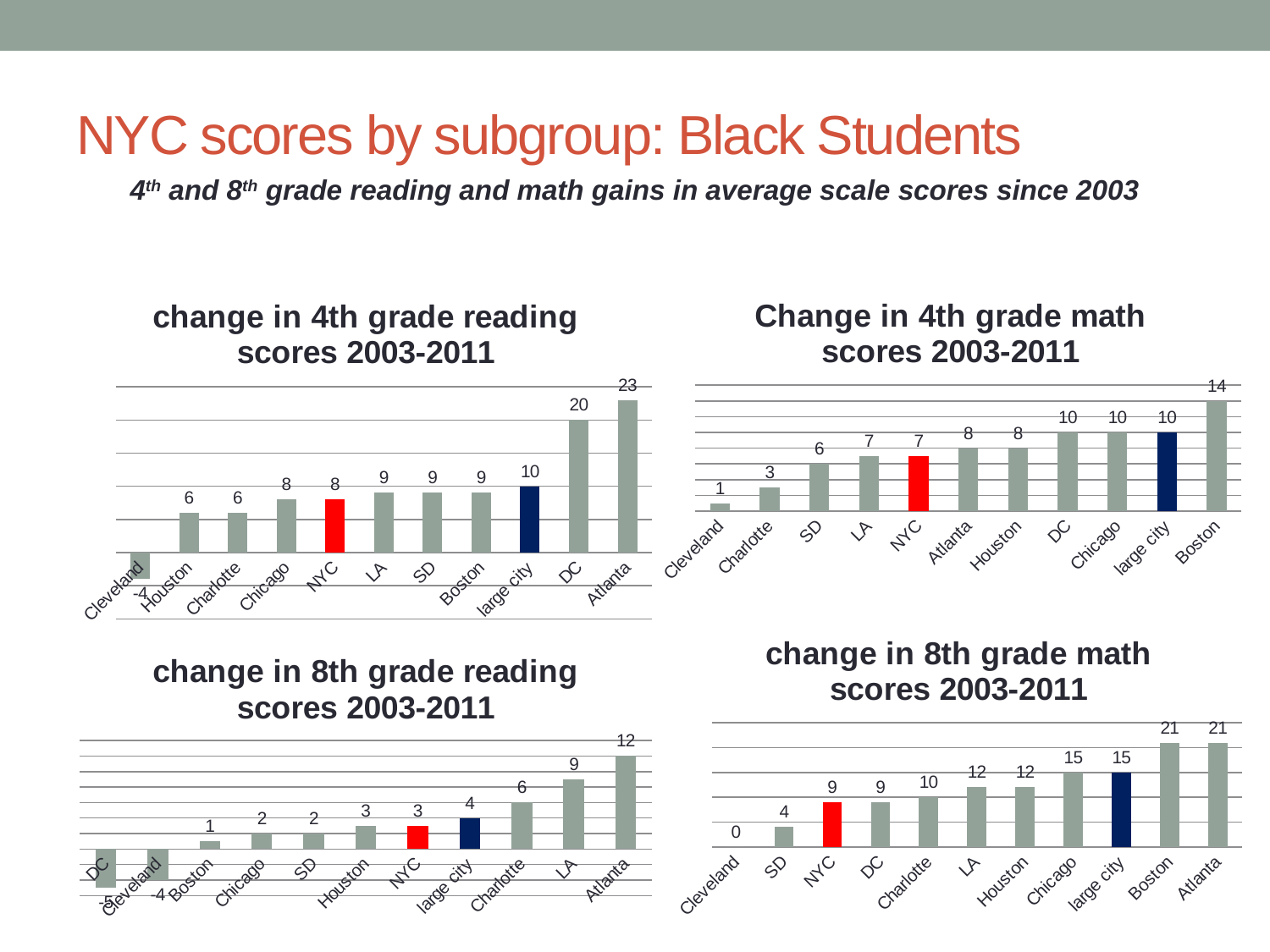
In the 'change in 8th grade reading scores 2003-2011' chart, what is the value for Atlanta? 12 In the 'Change in 4th grade math scores 2003-2011' chart, do the values rise or fall from left to right? rise What kind of chart is the 'change in 8th grade math scores 2003-2011' chart? bar chart In the 'change in 4th grade reading scores 2003-2011' chart, which city has the highest value? Atlanta In the 'change in 8th grade math scores 2003-2011' chart, what is the difference between the values for Boston and NYC? 12 In the 'change in 8th grade math scores 2003-2011' chart, what is the value for NYC? 9 In the 'change in 4th grade reading scores 2003-2011' chart, what is the value for NYC? 8 In the 'Change in 4th grade math scores 2003-2011' chart, which city has the lowest value? Cleveland How many categories are shown in the 'Change in 4th grade math scores 2003-2011' chart? 11 In the 'Change in 4th grade math scores 2003-2011' chart, what is the value for Boston? 14 In the 'change in 4th grade reading scores 2003-2011' chart, what is the difference between the values for Atlanta and DC? 3 In the 'change in 8th grade reading scores 2003-2011' chart, which is larger, the value for LA or the value for Charlotte? LA